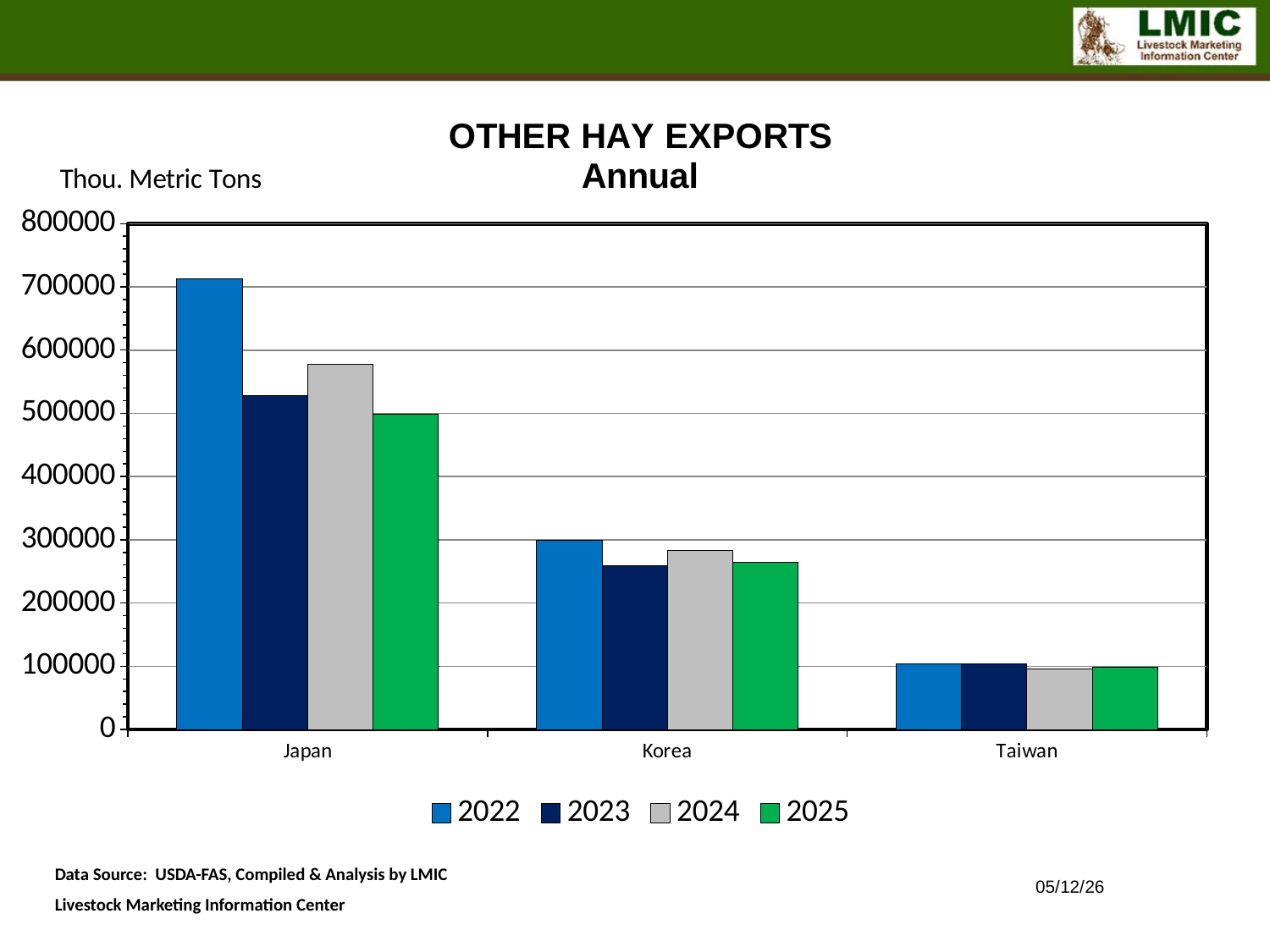
Is the value for Japan in 2022 greater or less than 600000? greater How many series does the legend list? 4 Which country has the highest other hay exports in 2022? Japan Is the value for Japan in 2023 greater or less than 500000? greater Which country has the lowest other hay exports in 2025? Taiwan For Japan, which year has the highest other hay exports? 2022 For Japan, which is larger: the 2023 value or the 2024 value? 2024 What unit is shown on the y axis of the chart? Thou. Metric Tons Is the value for Korea in 2023 greater or less than 300000? less How many countries are shown on the x axis of the chart? 3 What type of chart is shown on the slide? bar chart